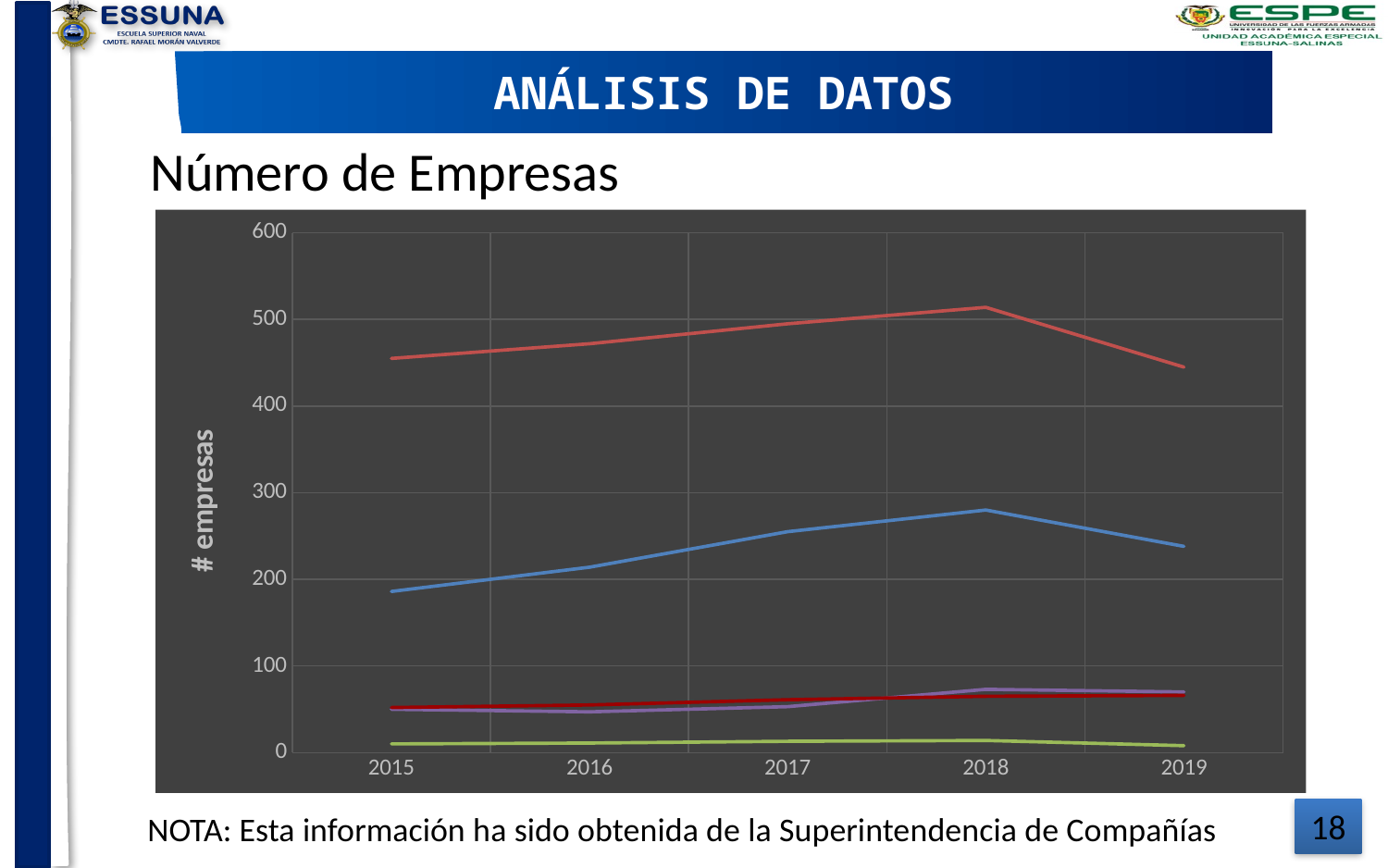
What is the label on the vertical axis of the chart? # empresas In which year does the red (top) line reach its highest value? 2018 Is the value of the blue line in 2018 greater or less than 300? less In which year is the blue line at its lowest value? 2015 What kind of chart is shown on the slide? line chart What is the title of the chart? Número de Empresas Is the value of the green (bottom) line in 2019 greater or less than 100? less Is the value of the blue line in 2015 greater or less than 200? less Does the red (top) line rise or fall between 2015 and 2018? rise In which year does the blue line reach its highest value? 2018 How many years are shown along the x axis of the chart? 5